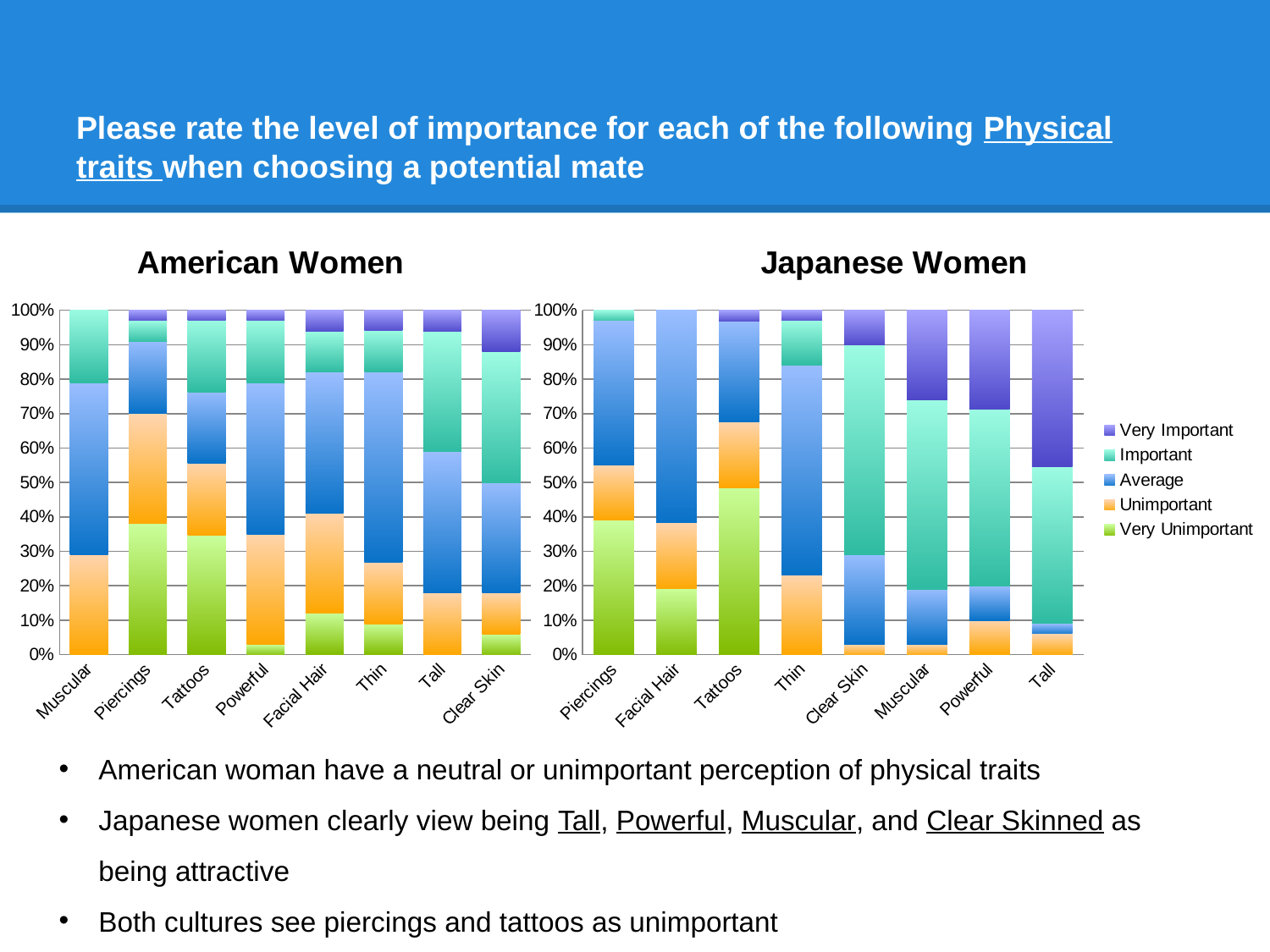
What is the first category on the x axis of the American Women chart? Muscular In the Japanese Women chart, which category has the largest Very Unimportant share? Tattoos In the Japanese Women chart, which category has the largest Very Important share? Tall How many categories are shown on the x axis of the Japanese Women chart? 8 In the Japanese Women chart, which has the larger Very Unimportant share, Tattoos or Piercings? Tattoos In the Japanese Women chart, is the Very Unimportant share for Tattoos greater or less than 40%? greater What kind of chart is the American Women chart? Stacked bar chart In the Japanese Women chart, is the Average share for Facial Hair greater or less than 50%? greater In the American Women chart, is the Unimportant share for Muscular greater or less than 20%? greater How many series does the legend list? 5 In the American Women chart, which has the larger Very Unimportant share, Piercings or Thin? Piercings